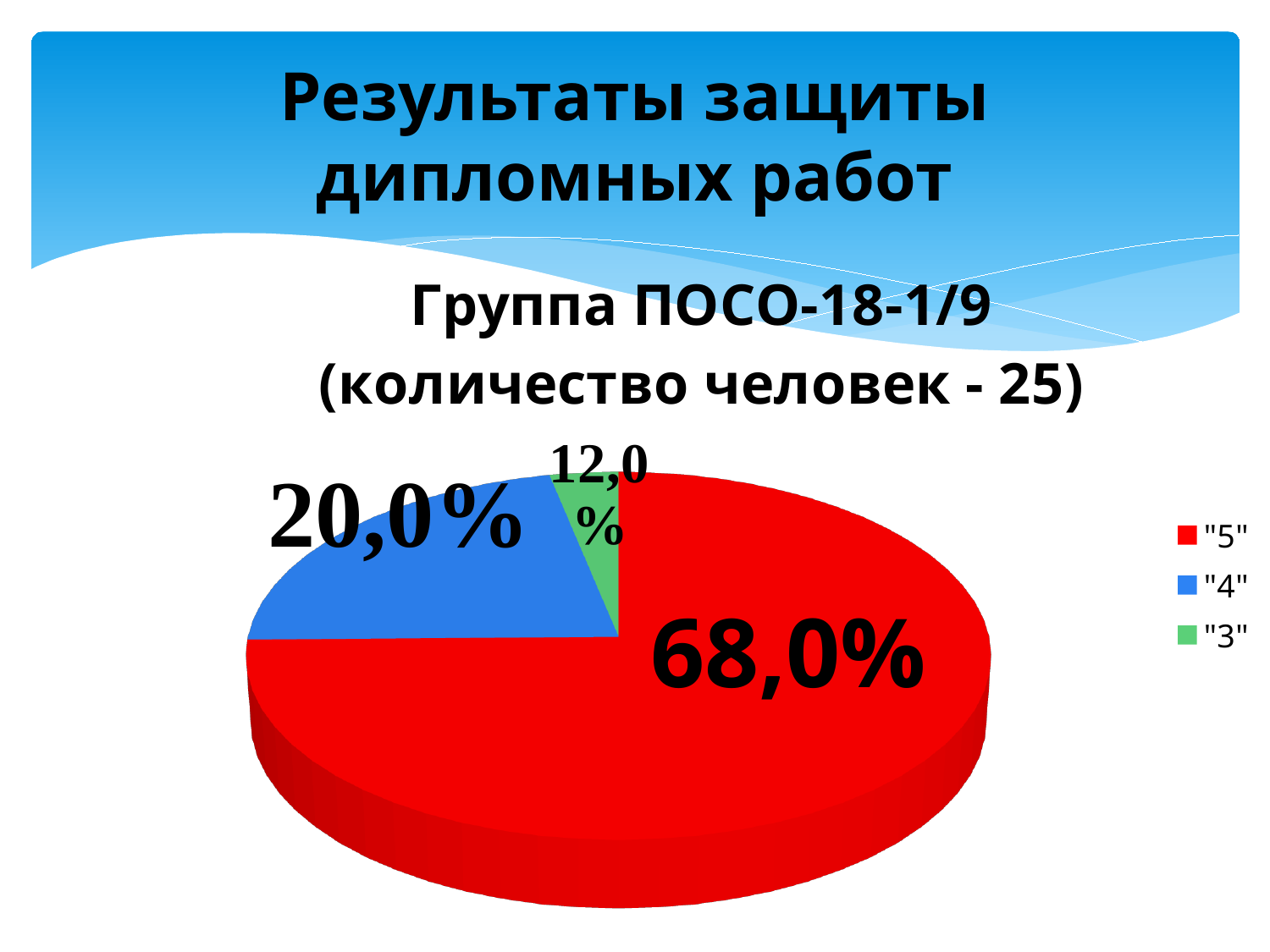
How many slices does the pie chart have? 3 What is the difference in percentage points between the "4" slice and the "3" slice? 8,0 Which grade has the largest share of the pie? "5" What share of the pie does the "5" slice represent? 68,0% What kind of chart is shown on the slide? Pie chart What colour is the "4" slice in the pie chart? Blue How many entries does the legend list? 3 What is the difference in percentage points between the "5" slice and the "4" slice? 48,0 What share of the pie does the "4" slice represent? 20,0% What share of the pie does the "3" slice represent? 12,0% Which grade has the smallest share of the pie? "3" Which slice is larger, "4" or "3"? "4"